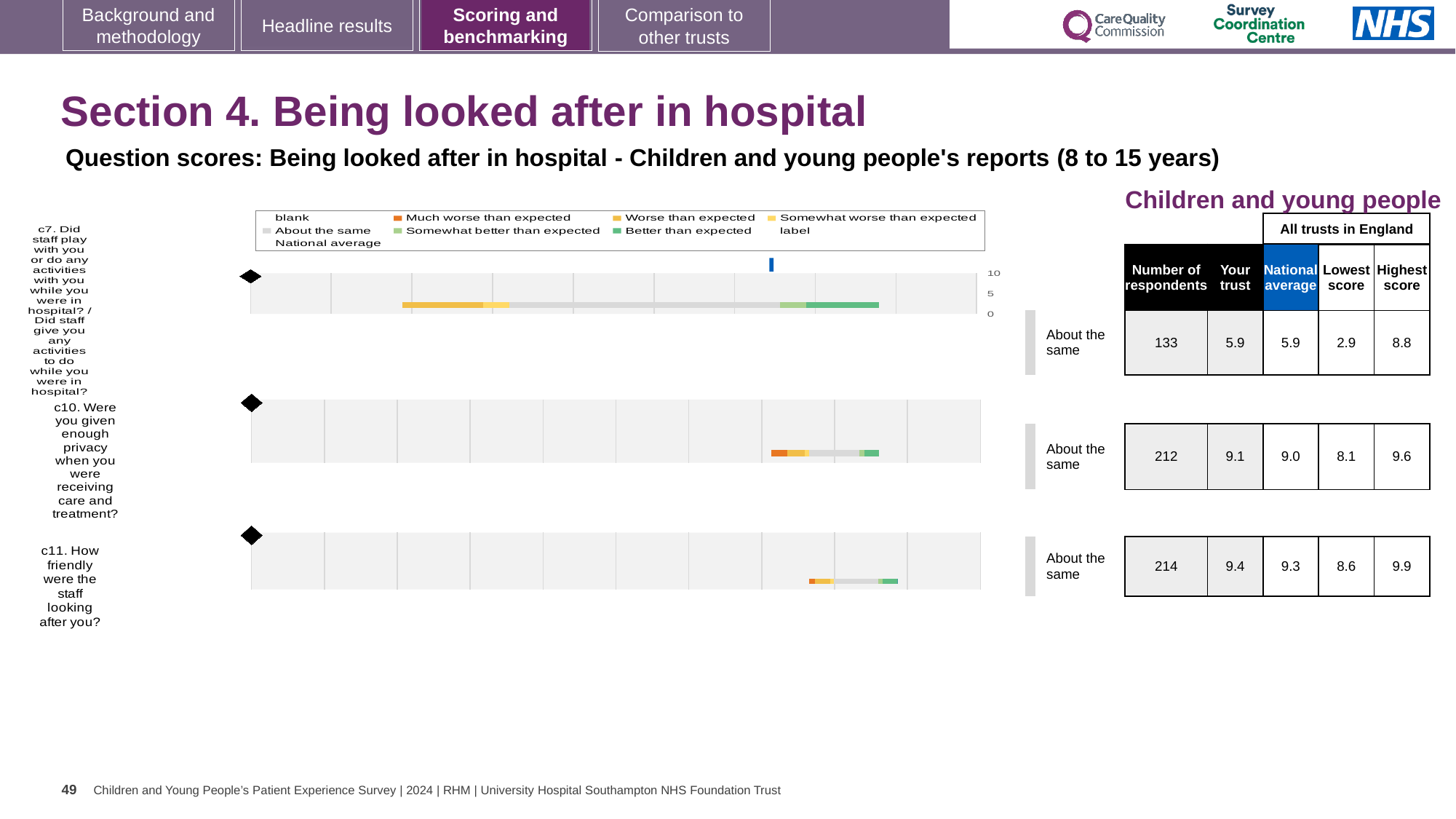
What is the 'Your trust' score for c10 (Were you given enough privacy when you were receiving care and treatment?)? 9.1 What is the difference between the highest score and the lowest score for c10? 1.5 For c10, which is larger: the 'Your trust' score or the national average? Your trust How many questions (c7, c10, c11) are plotted on the slide? 3 What benchmark category is shown for c7? About the same Which question has the highest 'Your trust' score? c11 What kind of chart is used to show the question scores for Being looked after in hospital? Bar chart Which question has the lowest 'Lowest score' across all trusts in England? c7 What is the difference between the highest score and the lowest score for c11? 1.3 What is the national average score for c11 (How friendly were the staff looking after you?)? 9.3 How many respondents answered c7 (Did staff play with you or do any activities with you while you were in hospital?)? 133 How many entries does the chart legend list? 9